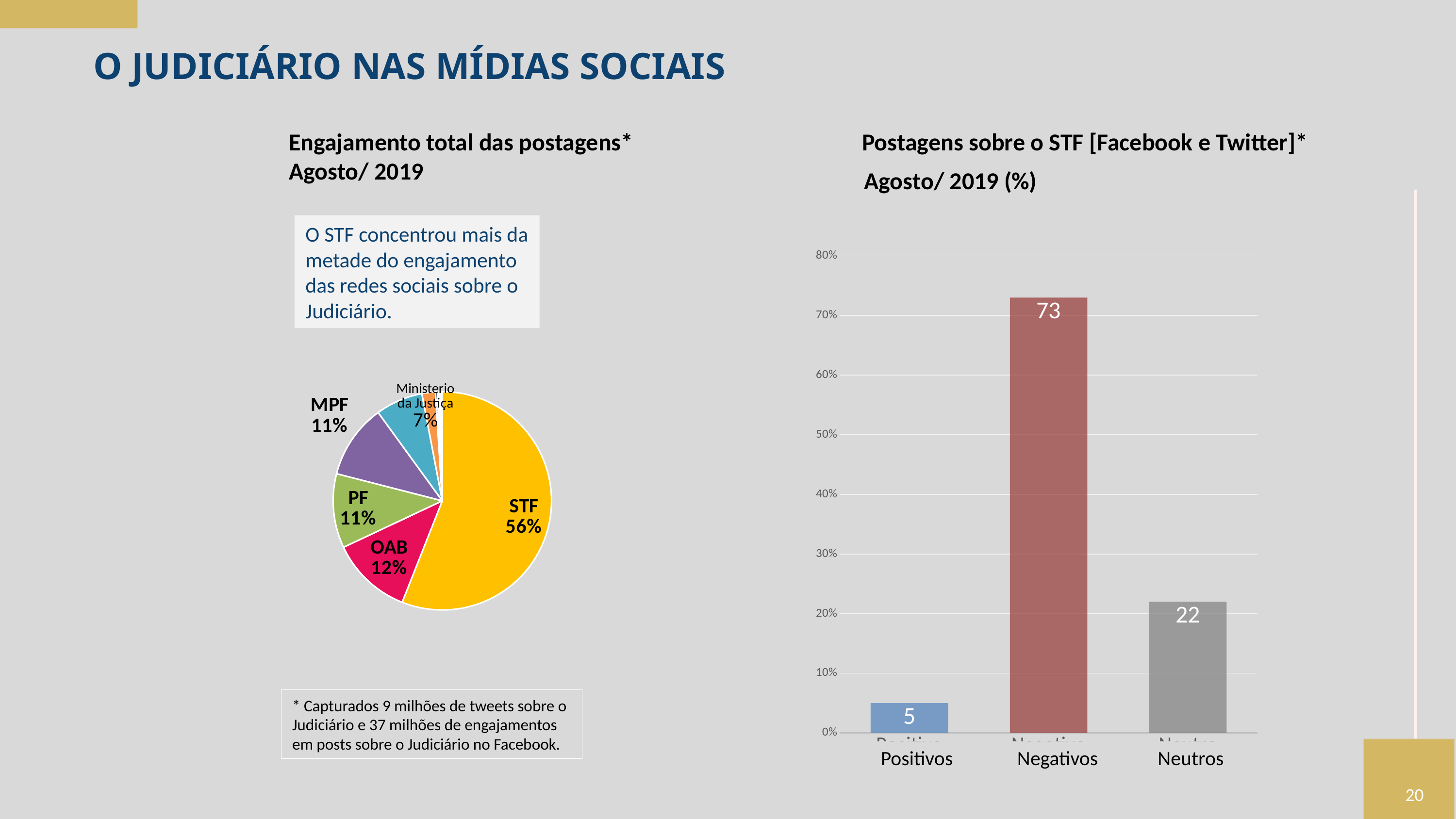
In the bar chart 'Postagens sobre o STF [Facebook e Twitter]', what is the value for Neutros? 22 In the bar chart 'Postagens sobre o STF [Facebook e Twitter]', what is the value for Positivos? 5 What kind of chart is the chart on the right of the slide, 'Postagens sobre o STF [Facebook e Twitter]'? Bar chart In the pie chart 'Engajamento total das postagens', what share does STF have? 56% In the pie chart 'Engajamento total das postagens', which labelled slice is the largest? STF In the bar chart 'Postagens sobre o STF [Facebook e Twitter]', which category has the highest value? Negativos In the pie chart 'Engajamento total das postagens', what share does OAB have? 12% What kind of chart is the chart on the left of the slide, 'Engajamento total das postagens'? Pie chart In the bar chart 'Postagens sobre o STF [Facebook e Twitter]', how many categories are shown on the x axis? 3 In the bar chart 'Postagens sobre o STF [Facebook e Twitter]', what is the difference between the values for Negativos and Neutros? 51 In the bar chart 'Postagens sobre o STF [Facebook e Twitter]', what is the value for Negativos? 73 In the bar chart 'Postagens sobre o STF [Facebook e Twitter]', which category has the lowest value? Positivos